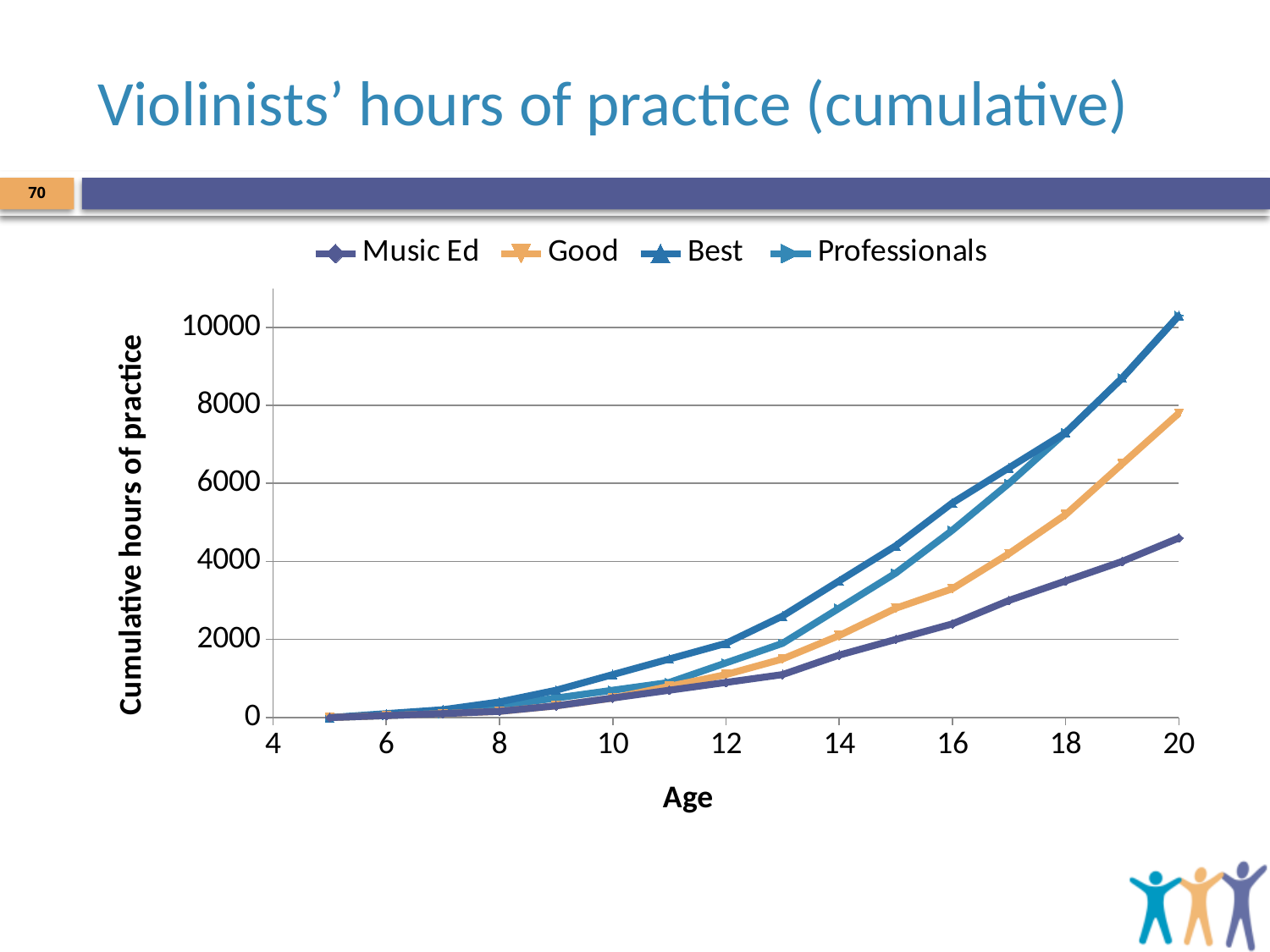
What is the title of the vertical axis? Cumulative hours of practice Is the value for Music Ed at age 20 greater or less than 4000? greater Do the cumulative hours of practice rise or fall as age increases? rise Is the value for Best at age 20 greater or less than 10000? greater How many series does the legend list? 4 Is the value for Good at age 16 greater or less than 4000? less At age 16, which is larger: Best or Professionals? Best At age 20, which is larger: Good or Music Ed? Good What kind of chart is shown on the slide? line chart Which series has the lowest cumulative hours of practice at age 20? Music Ed